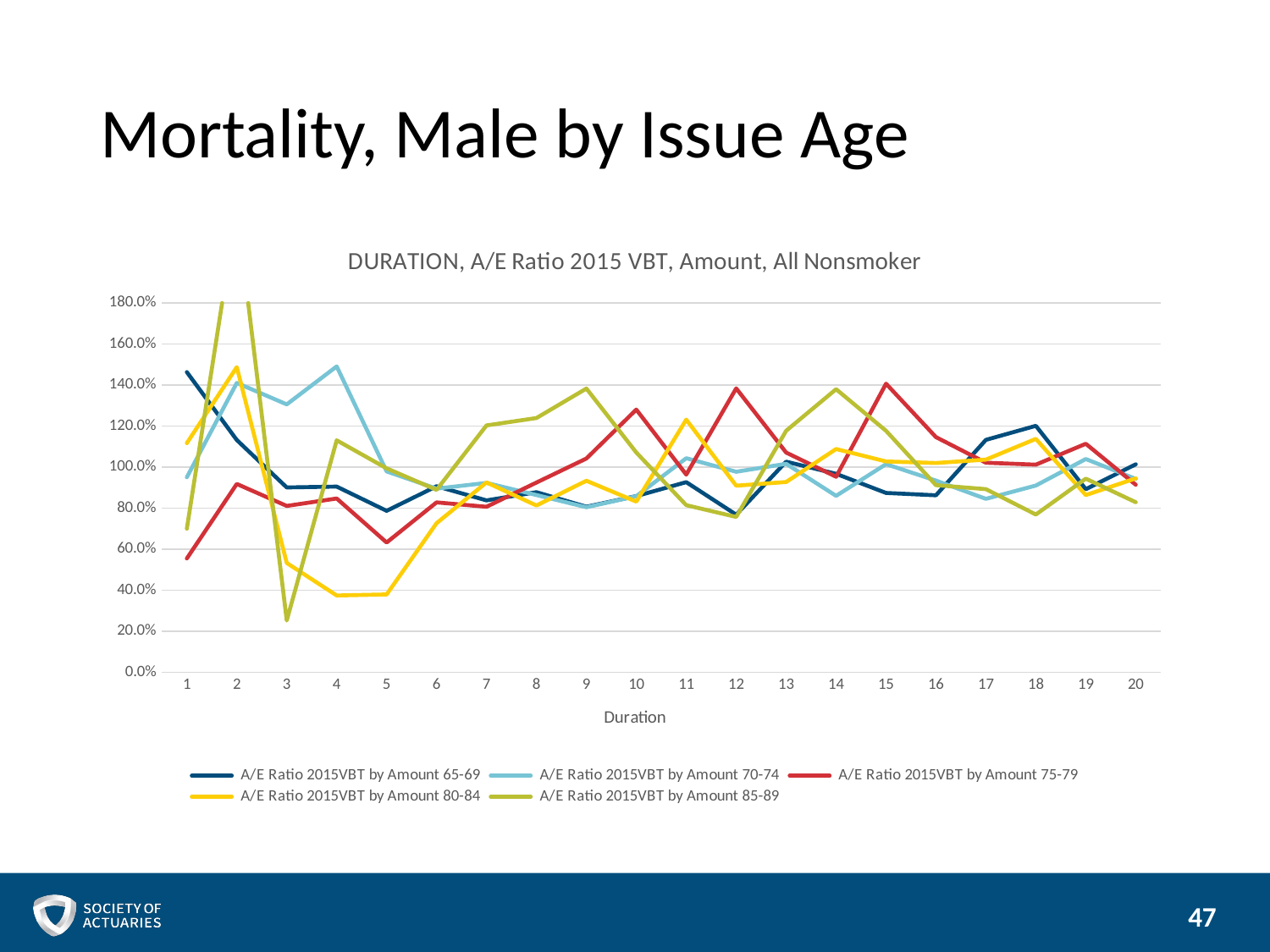
What kind of chart is shown on the slide? line chart What is the title of the chart? DURATION, A/E Ratio 2015 VBT, Amount, All Nonsmoker At duration 1, which series has the larger value: A/E Ratio 2015VBT by Amount 65-69 or A/E Ratio 2015VBT by Amount 75-79? A/E Ratio 2015VBT by Amount 65-69 Is the value for A/E Ratio 2015VBT by Amount 70-74 at duration 4 greater or less than 140.0%? greater At duration 4, which series has the larger value: A/E Ratio 2015VBT by Amount 70-74 or A/E Ratio 2015VBT by Amount 80-84? A/E Ratio 2015VBT by Amount 70-74 Does the A/E Ratio 2015VBT by Amount 65-69 series rise or fall from duration 1 to duration 5? fall Is the value for A/E Ratio 2015VBT by Amount 75-79 at duration 15 greater or less than 120.0%? greater Is the value for A/E Ratio 2015VBT by Amount 75-79 at duration 1 greater or less than 60.0%? less How many durations are plotted along the x axis? 20 How many series does the legend list? 5 What is the label of the x axis? Duration